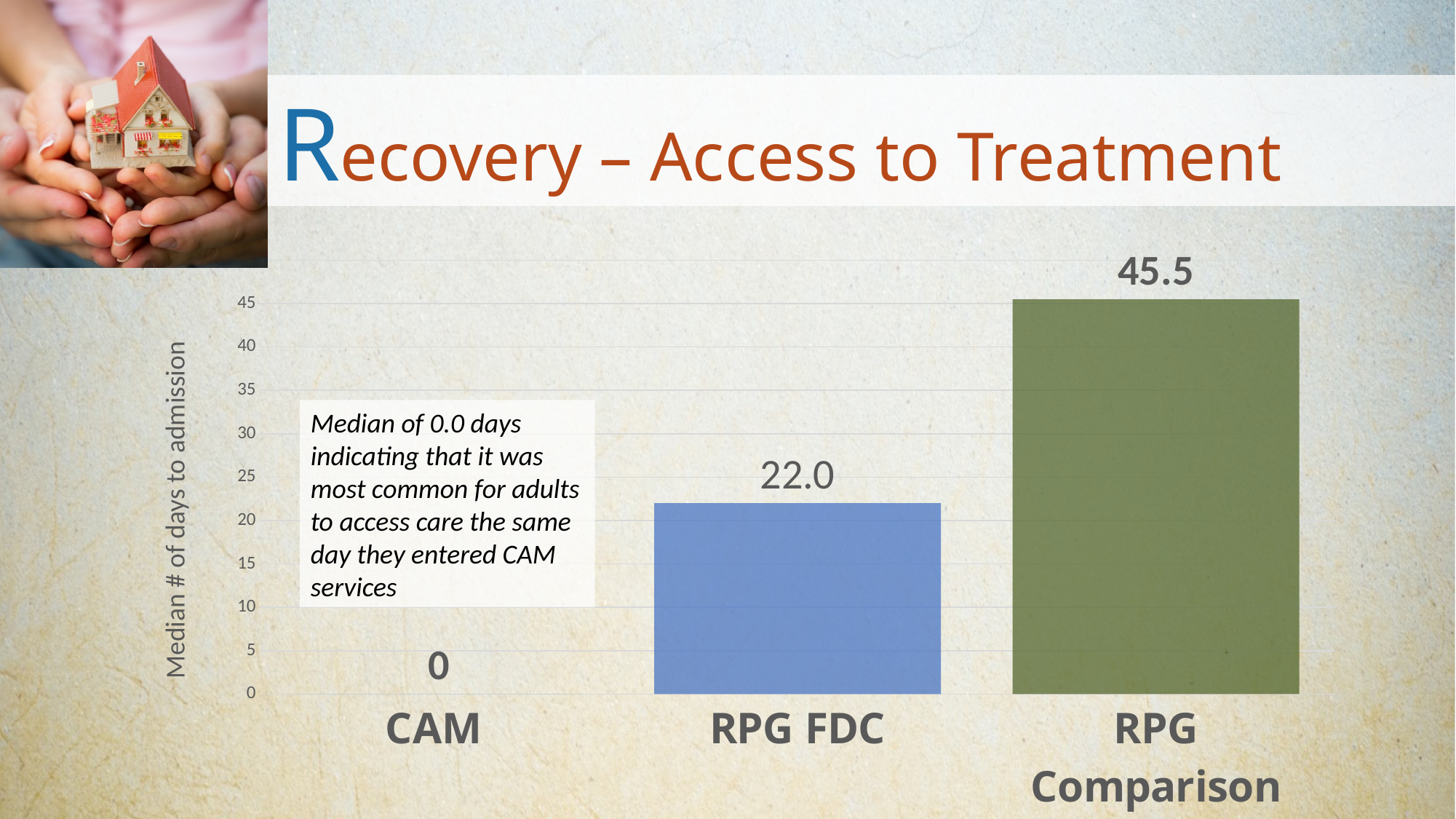
What is the median number of days to admission for CAM? 0 What is the median number of days to admission for RPG Comparison? 45.5 Which category has the highest median number of days to admission? RPG Comparison How many categories are shown on the x axis of the chart? 3 Which category has the lowest median number of days to admission? CAM Is the value for RPG FDC greater or less than 25? less Is the value for RPG Comparison greater or less than 40? greater What is the difference in median days to admission between RPG Comparison and RPG FDC? 23.5 What is the label of the vertical axis of the chart? Median # of days to admission Which has a larger median number of days to admission, RPG FDC or RPG Comparison? RPG Comparison What kind of chart is shown on the slide? Bar chart What is the median number of days to admission for RPG FDC? 22.0